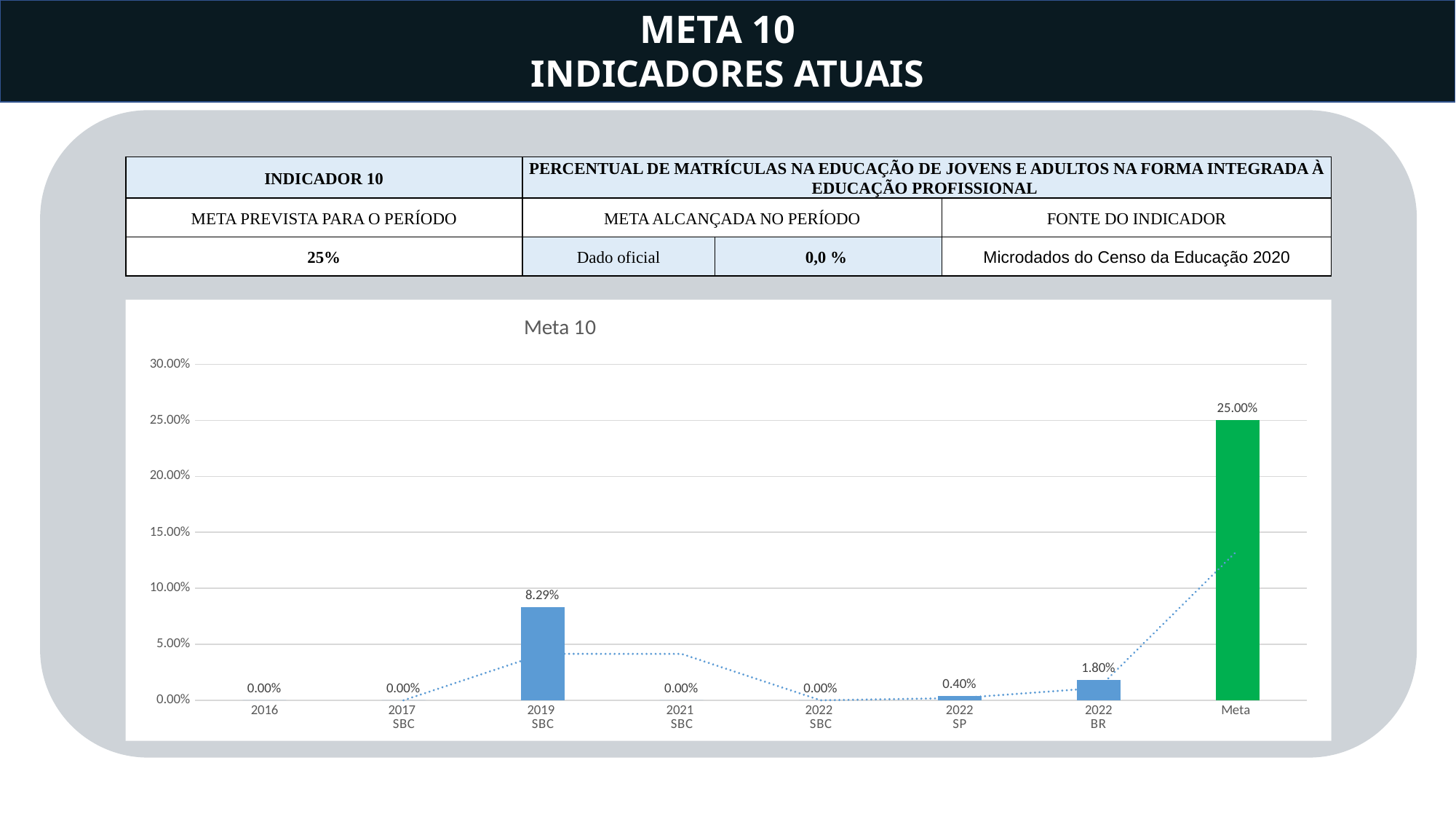
Which category has the highest value in the Meta 10 chart? Meta What kind of chart is the Meta 10 chart? Bar chart What is the value shown for the Meta bar in the Meta 10 chart? 25.00% What is the value for 2022 BR in the Meta 10 chart? 1.80% What is the difference between the 2022 BR value and the 2022 SP value in the Meta 10 chart? 1.40% What is the value for 2021 SBC in the Meta 10 chart? 0.00% What is the value for 2022 SP in the Meta 10 chart? 0.40% How many categories are shown on the x axis of the Meta 10 chart? 8 Which is larger in the Meta 10 chart, the value for 2019 SBC or the value for 2022 BR? 2019 SBC What is the difference between the Meta value and the 2019 SBC value in the Meta 10 chart? 16.71% What colour is the Meta bar in the Meta 10 chart? Green What is the value for 2019 SBC in the Meta 10 chart? 8.29%